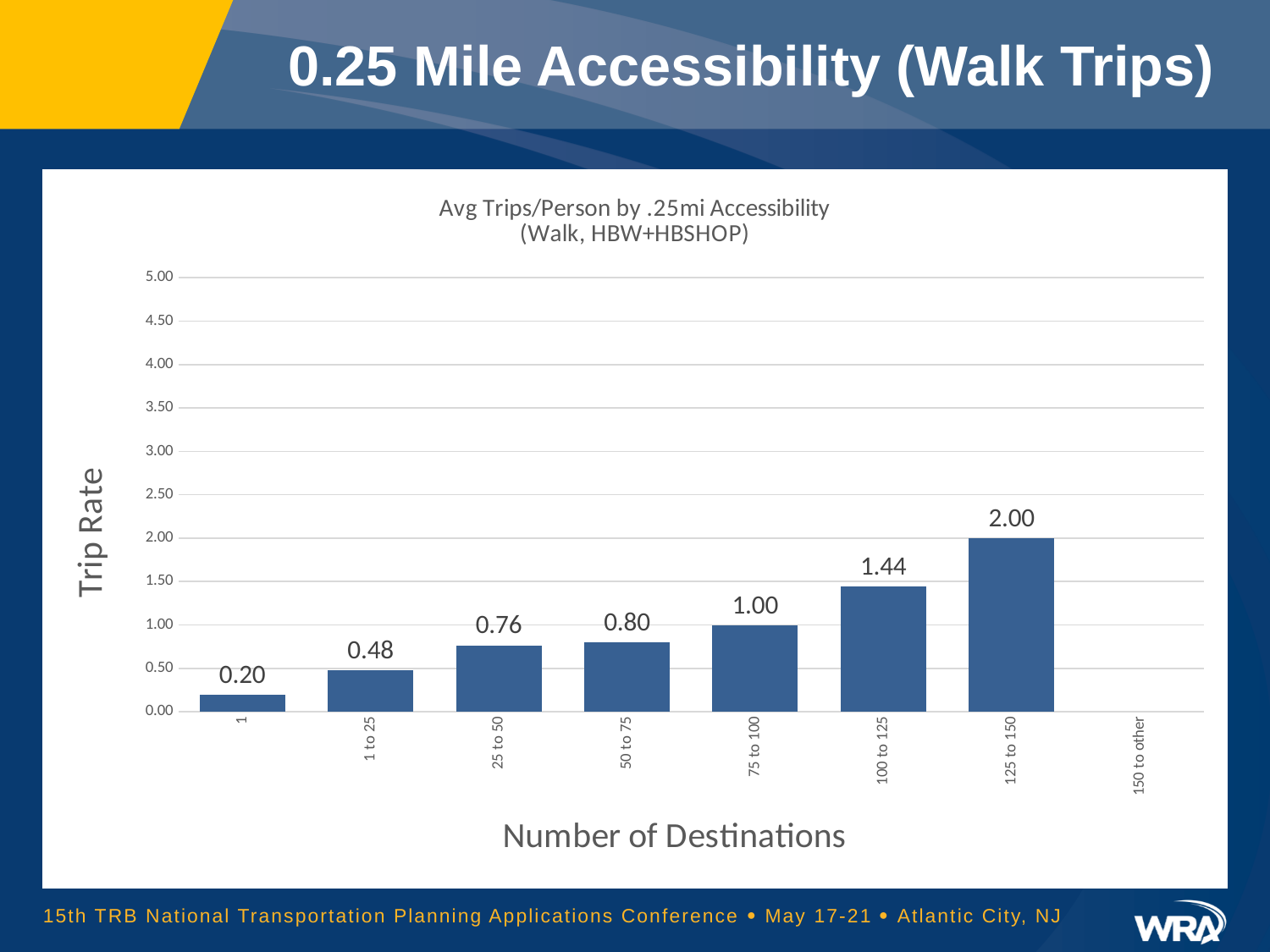
What is the difference in trip rate between the 125 to 150 and 100 to 125 categories? 0.56 Which number-of-destinations category has the lowest plotted trip rate? 1 Which number-of-destinations category has the highest trip rate? 125 to 150 Do the trip rates rise or fall as the number of destinations increases from 1 to 125 to 150? rise What is the trip rate for the 125 to 150 destinations category? 2.00 What is the trip rate for the 1 to 25 destinations category? 0.48 Is the trip rate for 100 to 125 destinations greater or less than 1.00? greater What is the title of the y axis? Trip Rate What kind of chart is shown on the slide? bar chart Which has a higher trip rate, 50 to 75 destinations or 25 to 50 destinations? 50 to 75 What is the trip rate for the 75 to 100 destinations category? 1.00 How many categories are labeled on the x axis? 8